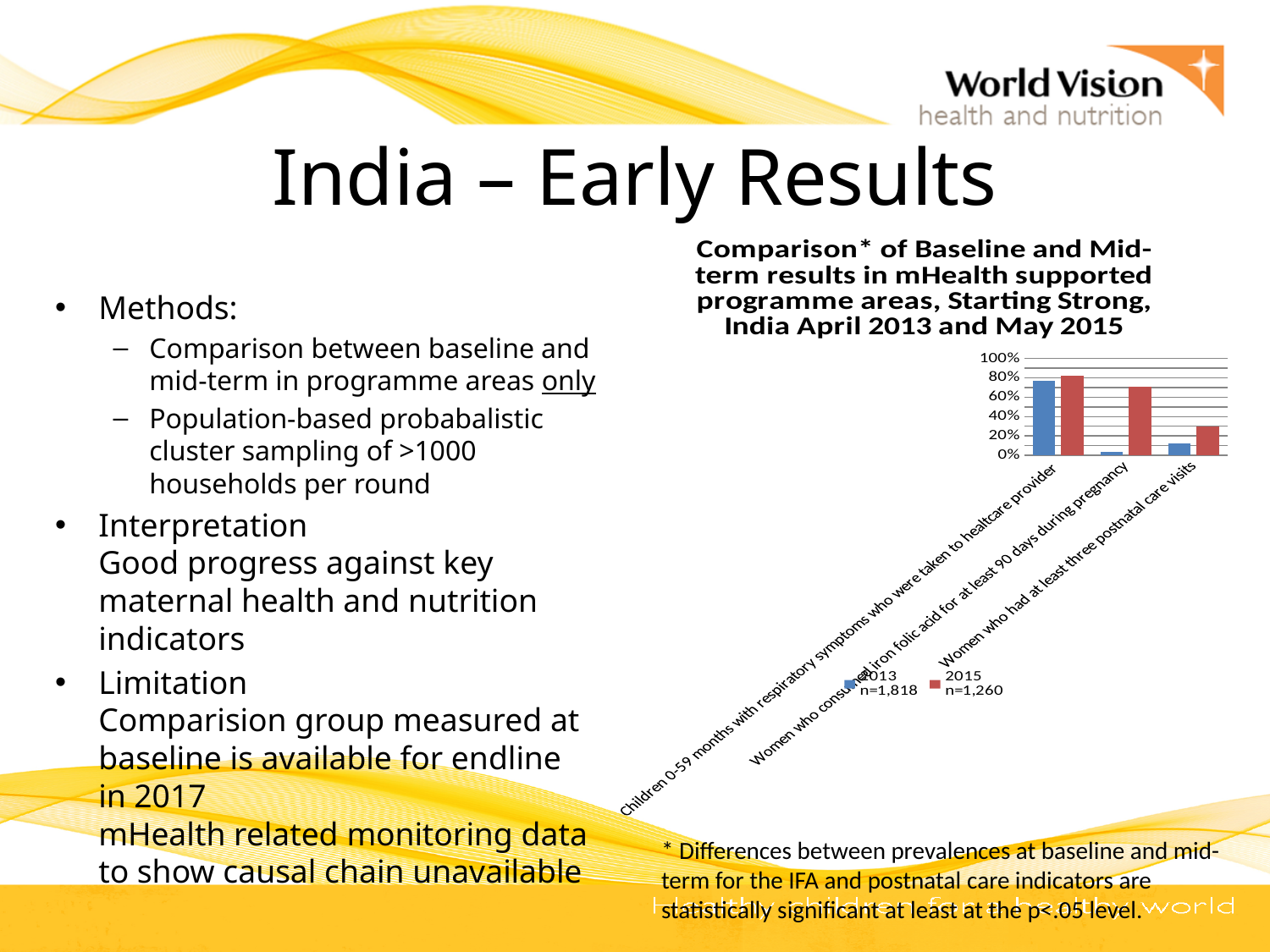
For 'Women who consumed iron folic acid for at least 90 days during pregnancy', which series has the larger value, 2013 or 2015? 2015 Is the 2015 value for 'Women who had at least three postnatal care visits' greater or less than 20%? greater What are the two series named in the chart's legend? 2013 n=1,818 and 2015 n=1,260 Which colour represents the 2015 series in the chart? red How many series does the chart's legend list? 2 Is the 2013 value for 'Women who had at least three postnatal care visits' greater or less than 20%? less Is the 2013 value for 'Women who consumed iron folic acid for at least 90 days during pregnancy' greater or less than 20%? less What kind of chart is shown on the slide? bar chart Which category has the lowest 2013 value in the chart? Women who consumed iron folic acid for at least 90 days during pregnancy How many categories are shown on the x axis of the chart? 3